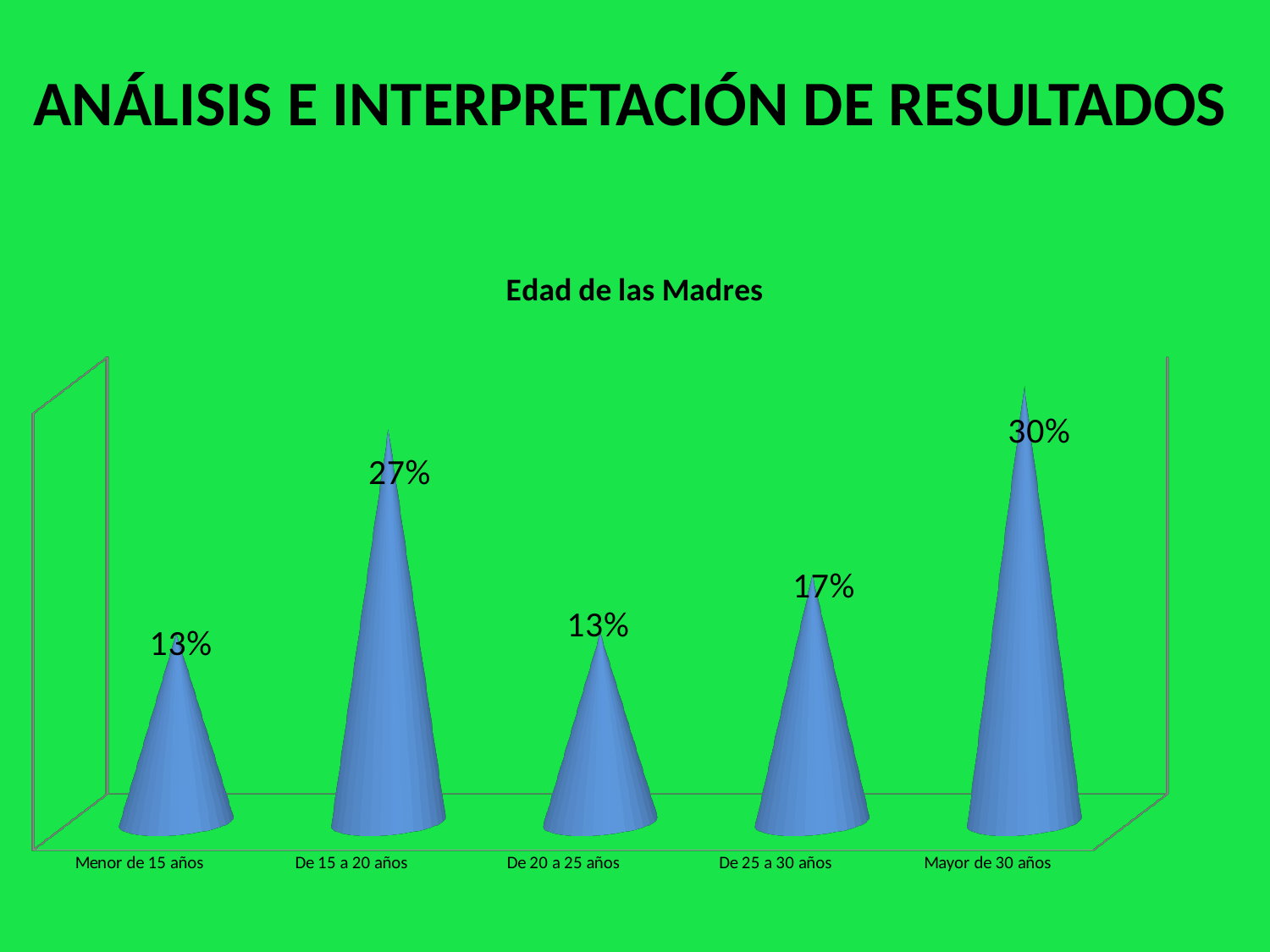
How many categories are shown in the chart? 5 What is the value for "De 15 a 20 años" in the Edad de las Madres chart? 27% What kind of chart is shown on the slide? Bar chart What is the difference between the values for "Mayor de 30 años" and "De 15 a 20 años"? 3% Which category has the highest value? Mayor de 30 años What is the difference between the values for "De 25 a 30 años" and "De 20 a 25 años"? 4% What is the value for "Mayor de 30 años"? 30% What is the title of the chart? Edad de las Madres What is the value for "De 25 a 30 años"? 17% Which is larger, the value for "De 15 a 20 años" or the value for "De 25 a 30 años"? De 15 a 20 años Which two categories share the same value of 13%? Menor de 15 años and De 20 a 25 años What is the value for "Menor de 15 años"? 13%